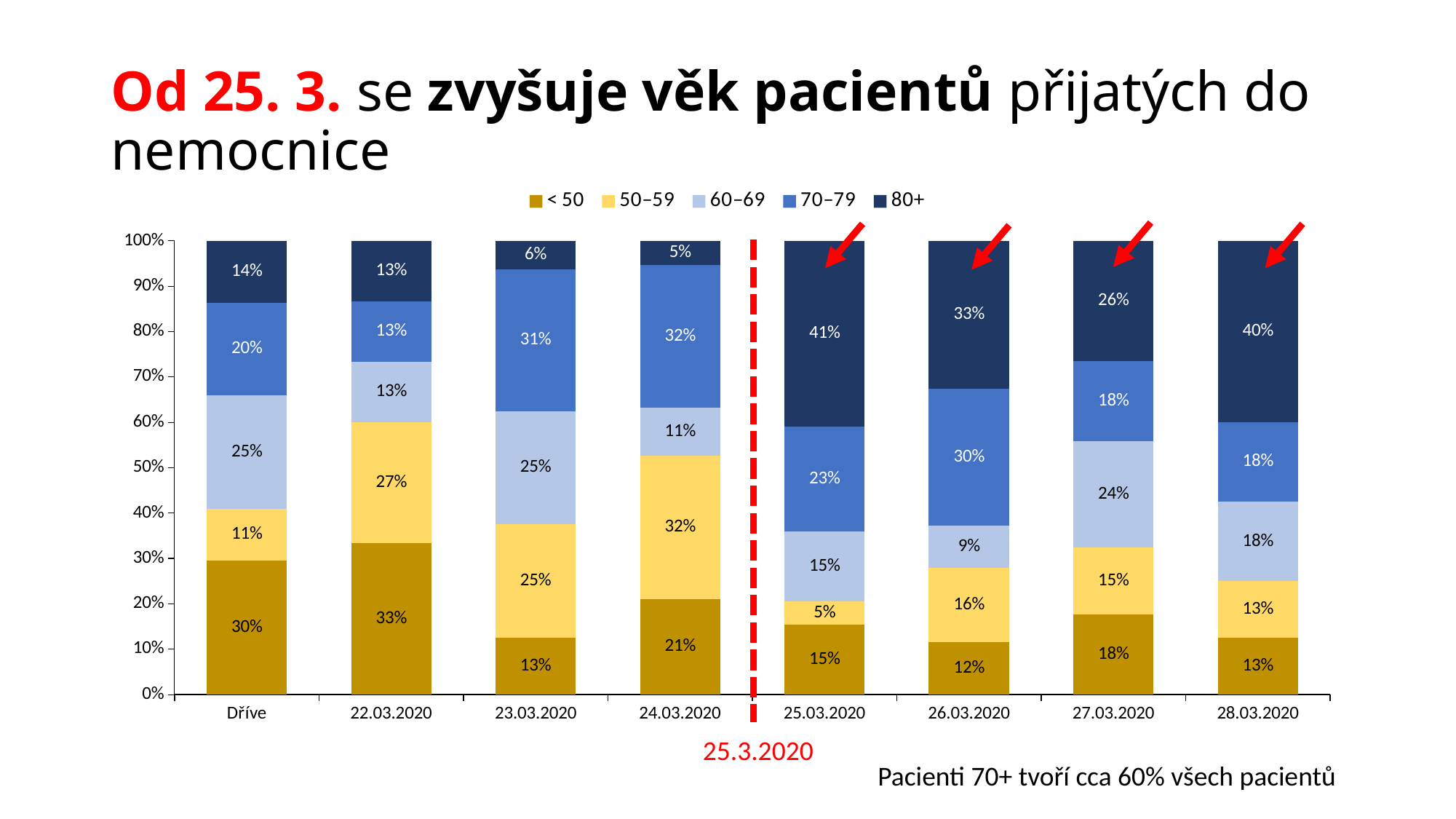
On which date does the 80+ age group have its highest share? 25.03.2020 What is the value for the < 50 age group on 22.03.2020? 33% What share of patients admitted on 25.03.2020 were aged 80+? 41% On which date does the 80+ age group have its lowest share? 24.03.2020 What kind of chart is shown on the slide? Stacked bar chart How many series does the legend list? 5 Which date is marked by the red dashed vertical line? 25.3.2020 What is the difference between the 80+ share on 28.03.2020 and on 24.03.2020? 35 percentage points Which is larger: the 50–59 share on 24.03.2020 or on 25.03.2020? 24.03.2020 How many categories are shown on the x axis? 8 What is the value for the 70–79 age group on 26.03.2020? 30% What share of patients in the 'Dříve' category were aged 60–69? 25%